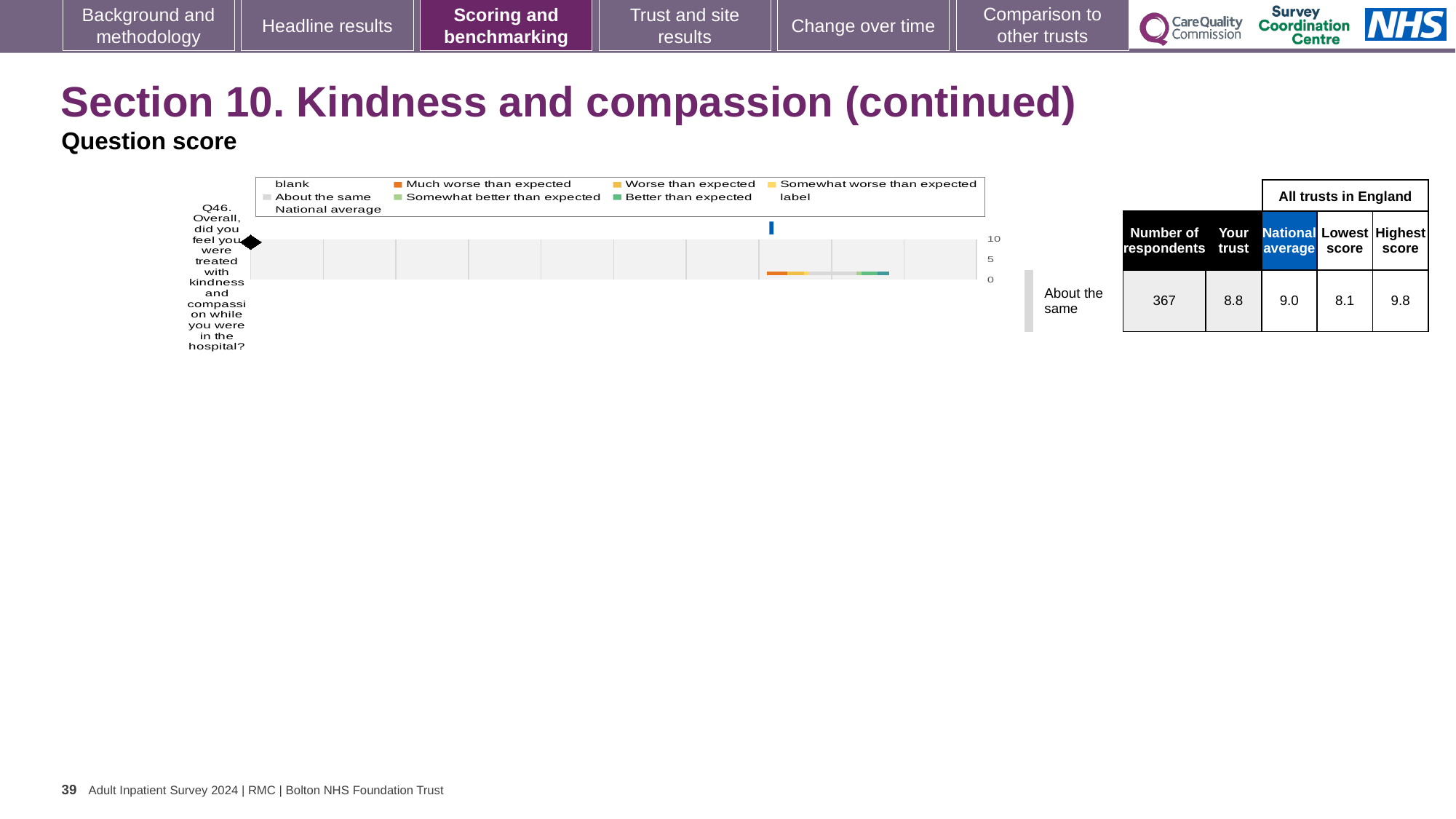
What is the Highest score among all trusts in England for Q46? 9.8 By how much does the National average exceed the Your trust score for Q46? 0.2 Which is larger for Q46, the Your trust score or the National average? National average What is the National average score for Q46? 9.0 How many respondents answered Q46? 367 What is the difference between the Highest score and the Lowest score for Q46? 1.7 What is the highest tick value shown on the chart's score axis? 10 Which benchmarking category is the trust's Q46 result placed in? About the same Is the Your trust score for Q46 greater or less than 5? greater What is the Lowest score among all trusts in England for Q46? 8.1 What kind of chart is shown on the slide? bar chart What is the score for Your trust on Q46? 8.8